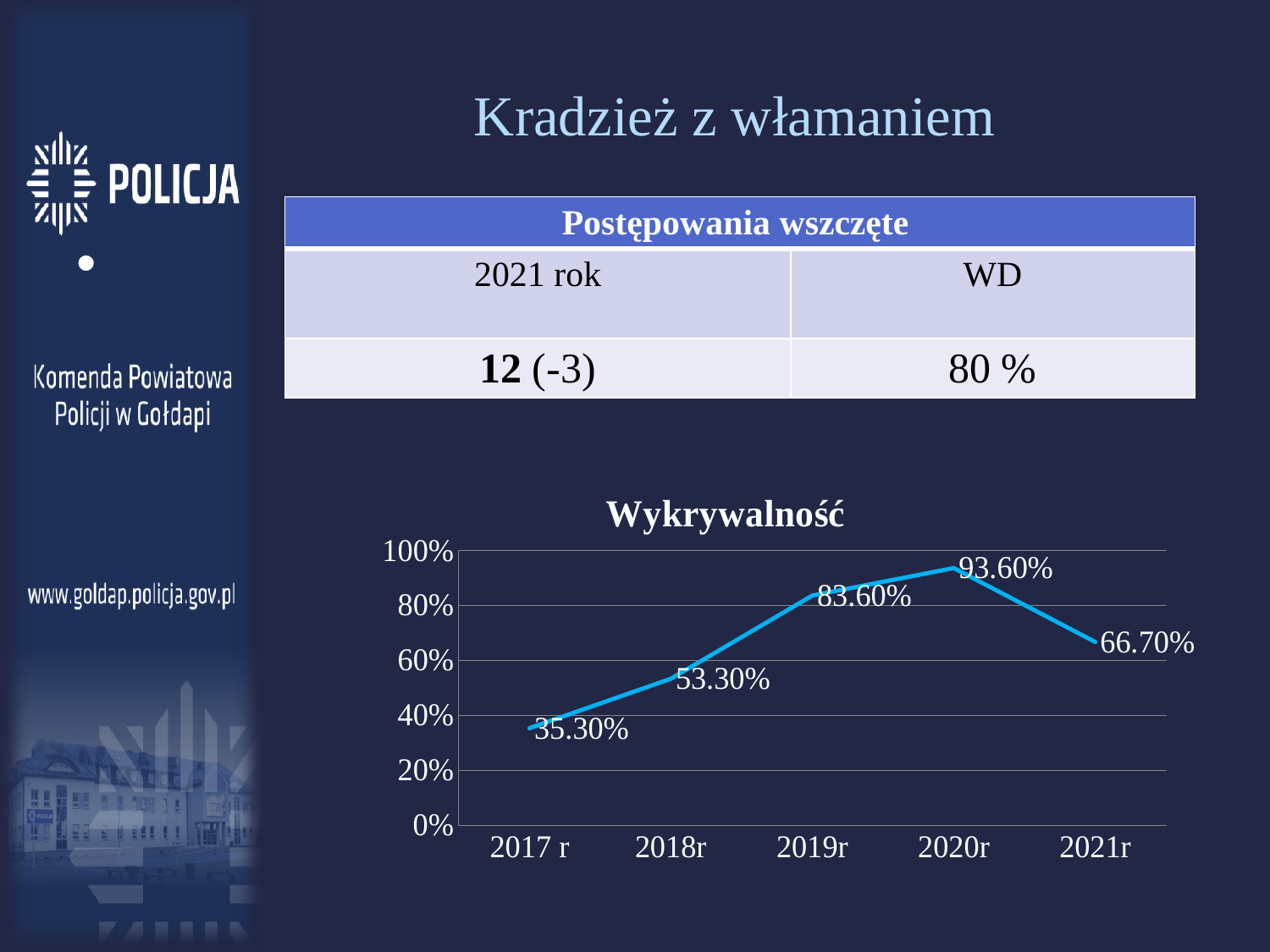
What is the difference between the values for 2018r and 2017 r in the Wykrywalność chart? 18.00% Which year has the lowest value in the Wykrywalność chart? 2017 r How many years are plotted in the Wykrywalność chart? 5 What is the difference between the values for 2020r and 2021r in the Wykrywalność chart? 26.90% Which is larger in the Wykrywalność chart, the value for 2018r or the value for 2021r? 2021r Which year has the highest value in the Wykrywalność chart? 2020r What is the value for 2019r in the Wykrywalność chart? 83.60% Is the value for 2019r in the Wykrywalność chart greater or less than 80%? greater What is the value for 2021r in the Wykrywalność chart? 66.70% What kind of chart is the Wykrywalność chart? line chart What is the title of the chart on the slide? Wykrywalność What is the value for 2017 r in the Wykrywalność chart? 35.30%